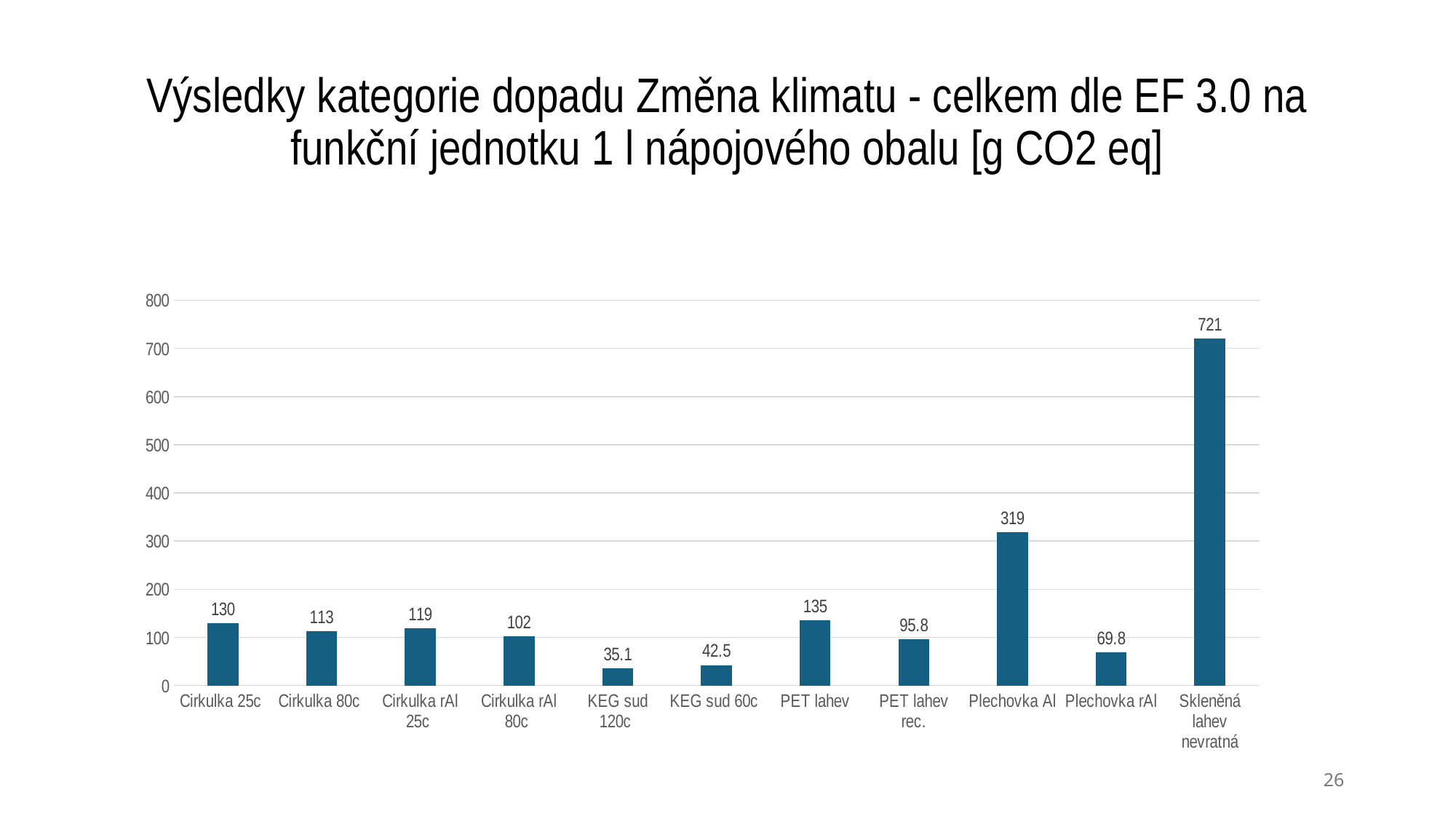
What is the difference between the values for Skleněná lahev nevratná and Plechovka Al? 402 What is the value for Plechovka rAl? 69.8 What kind of chart is shown on the slide? Bar chart What is the value for KEG sud 120c? 35.1 How many categories are shown on the x axis? 11 Which is larger, the value for PET lahev or the value for Cirkulka rAl 80c? PET lahev What is the difference between the values for Cirkulka 25c and Cirkulka 80c? 17 Which category has the highest value? Skleněná lahev nevratná What is the value for PET lahev rec.? 95.8 Which category has the lowest value? KEG sud 120c Is the value for Plechovka Al greater or less than 300? greater What is the value for Skleněná lahev nevratná? 721